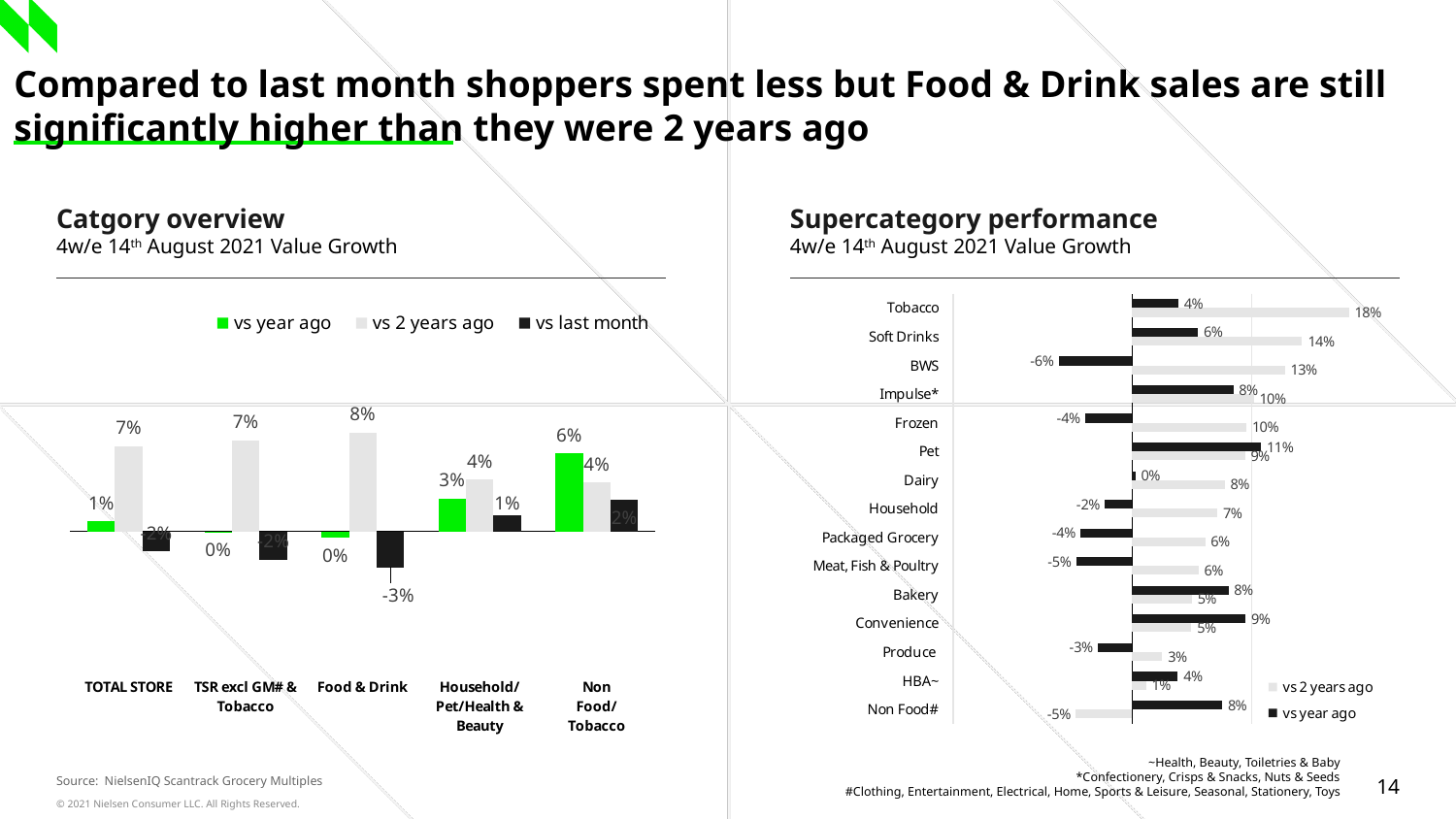
In the 'Catgory overview' chart, what is the difference between the 'vs 2 years ago' and 'vs year ago' values for TOTAL STORE? 6% In the 'Catgory overview' chart, which category has the highest 'vs year ago' value? Non Food/Tobacco In the 'Catgory overview' chart, what is the 'vs last month' value for Food & Drink? -3% In the 'Catgory overview' chart, what is the 'vs year ago' value for Non Food/Tobacco? 6% In the 'Supercategory performance' chart, which supercategory has the lowest 'vs year ago' value? BWS In the 'Catgory overview' chart, what is the 'vs 2 years ago' value for Food & Drink? 8% In the 'Supercategory performance' chart, what is the 'vs 2 years ago' value for Tobacco? 18% In the 'Supercategory performance' chart, what is the 'vs year ago' value for BWS? -6% In the 'Catgory overview' chart, how many series does the legend list? 3 In the 'Supercategory performance' chart, which is larger for Pet: the 'vs year ago' value or the 'vs 2 years ago' value? vs year ago What type of chart is the 'Supercategory performance' chart? Bar chart In the 'Supercategory performance' chart, how many supercategories are shown? 15